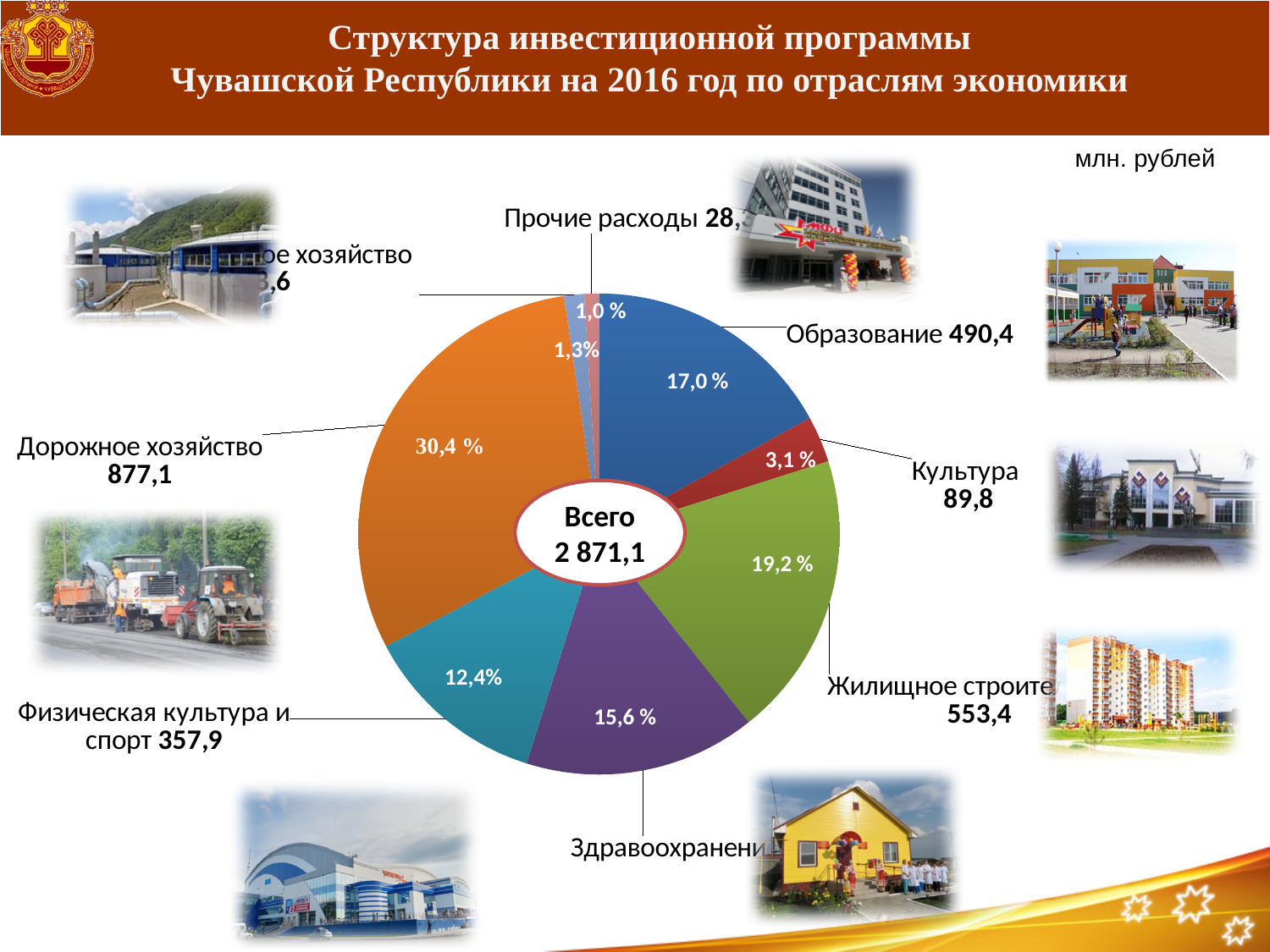
What is the value for Культура? 89,8 What is the value for Дорожное хозяйство? 877,1 Which sector has the largest slice of the pie? Дорожное хозяйство What share of the pie does Дорожное хозяйство take? 30,4 % What kind of chart is shown on the slide? pie chart What total is shown in the centre of the pie chart? 2 871,1 What is the difference between the values for Дорожное хозяйство and Образование? 386,7 What share of the pie does Здравоохранение take? 15,6 % What is the value for Физическая культура и спорт? 357,9 What is the value for Жилищное строительство? 553,4 Which sector has the smallest slice of the pie? Прочие расходы What is the value for Образование? 490,4